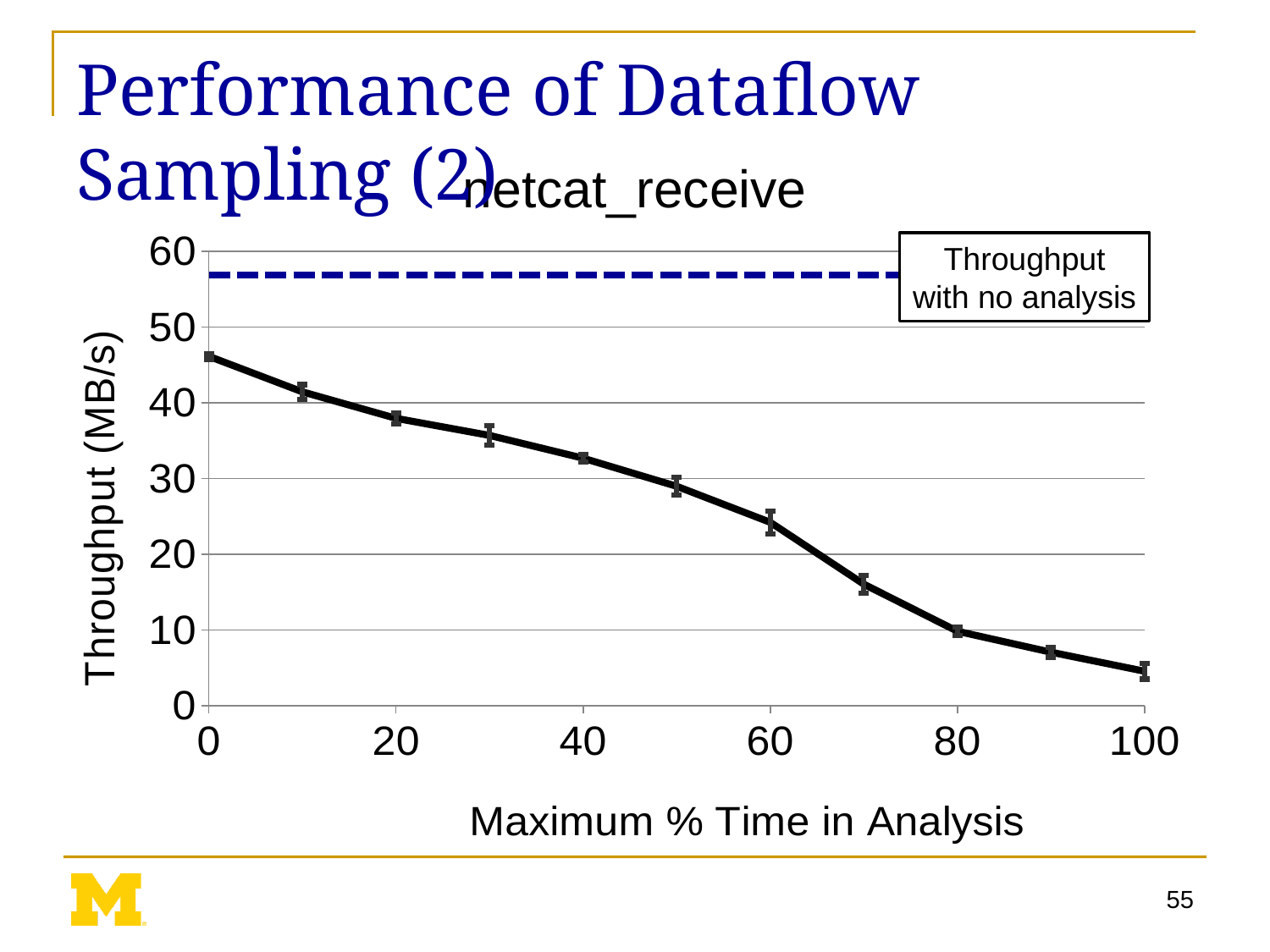
At which Maximum % Time in Analysis value is throughput highest? 0 How many data points are plotted on the solid line? 11 Which is larger: the throughput at 20% or at 60% Maximum Time in Analysis? 20% Does throughput rise or fall as Maximum % Time in Analysis increases? fall What does the dashed horizontal line in the chart represent? Throughput with no analysis Is the throughput at 0% Maximum Time in Analysis greater or less than 40 MB/s? greater What kind of chart is shown on the slide? line chart At which Maximum % Time in Analysis value is throughput lowest? 100 Is the throughput at 70% Maximum Time in Analysis greater or less than 20 MB/s? less Is the throughput at 40% Maximum Time in Analysis greater or less than 30 MB/s? greater What is the title of the chart? netcat_receive